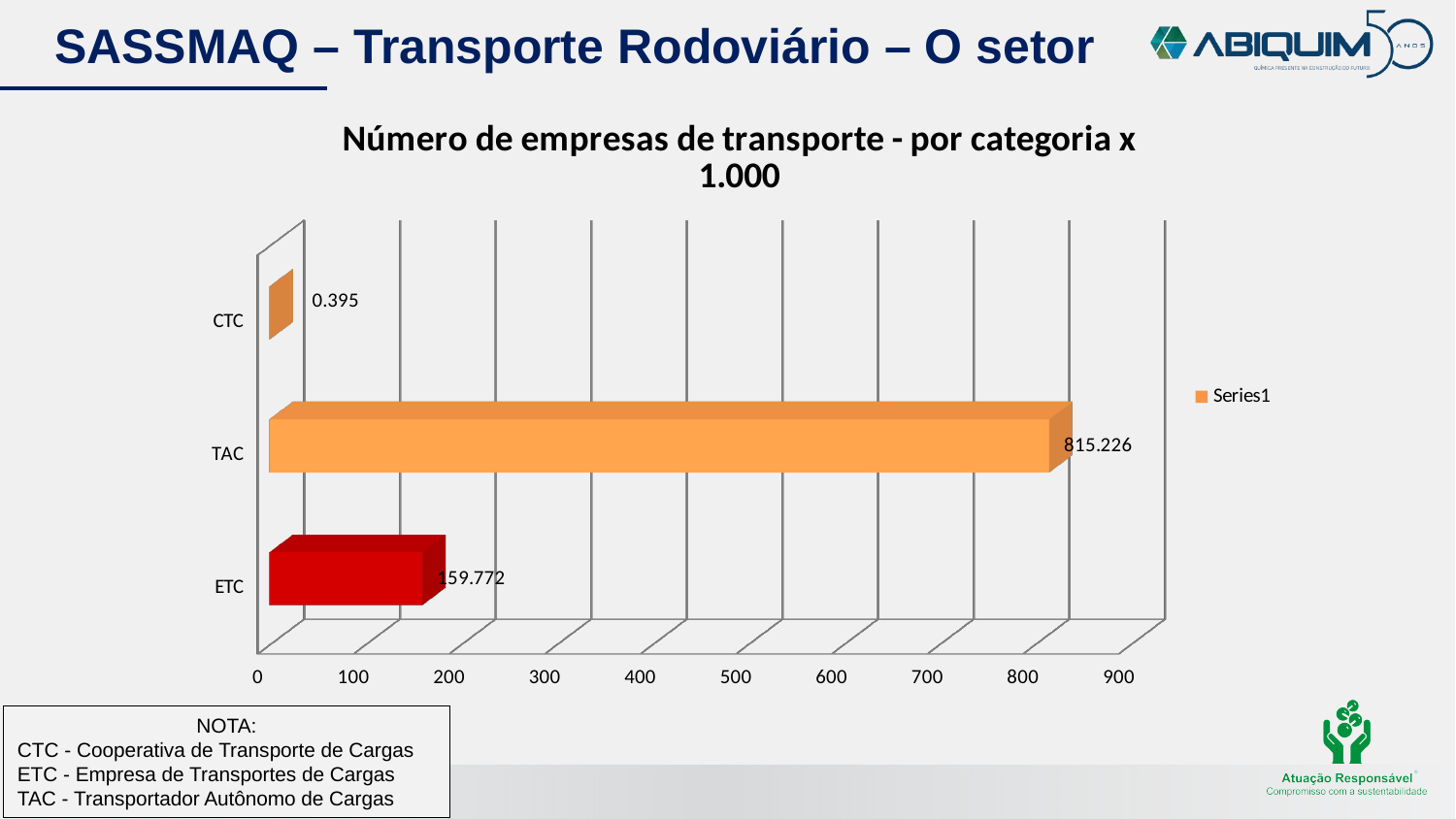
Which is larger, the value for ETC or the value for CTC? ETC What is the value for CTC? 0.395 What is the value for ETC? 159.772 What is the difference between the values for TAC and ETC? 655.454 What is the title of the chart? Número de empresas de transporte - por categoria x 1.000 Which category has the highest value? TAC Is the value for TAC greater or less than 800? greater Which category has the lowest value? CTC How many categories are shown in the chart? 3 What kind of chart is shown on the slide? Bar chart What is the value for TAC? 815.226 How many series does the legend list? 1